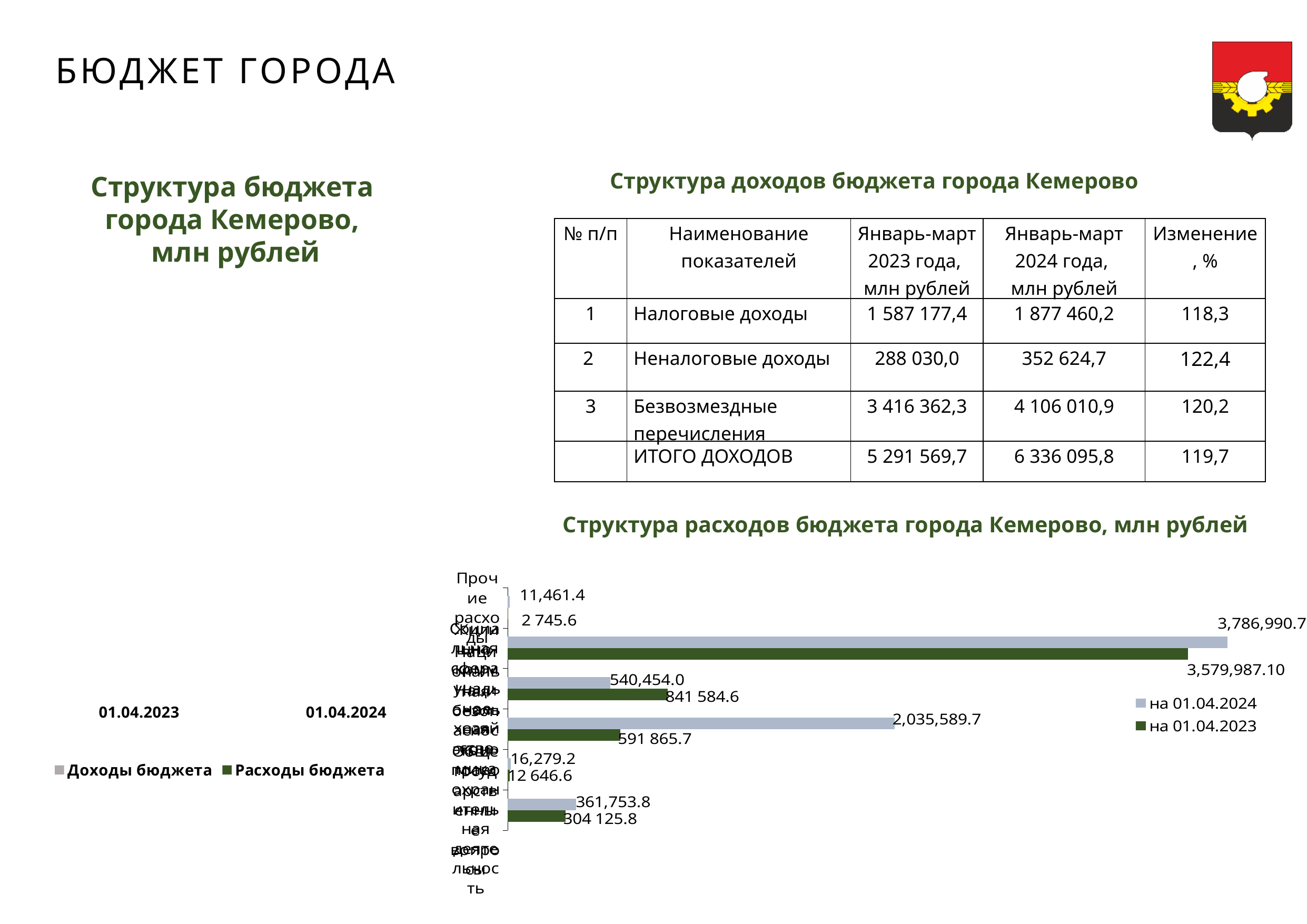
How many categories (groups of bars) are plotted in the 'Структура расходов бюджета города Кемерово, млн рублей' chart? 6 In the 'Структура расходов бюджета города Кемерово, млн рублей' chart, what is the smallest value in the 'на 01.04.2023' series? 2 745.6 In the 'Структура расходов бюджета города Кемерово, млн рублей' chart, what is the smallest value in the 'на 01.04.2024' series? 11,461.4 What kind of chart is the 'Структура расходов бюджета города Кемерово, млн рублей' chart? bar chart In the 'Структура расходов бюджета города Кемерово, млн рублей' chart, what is the largest value in the 'на 01.04.2024' series? 3,786,990.7 What are the two legend entries of the 'Структура бюджета города Кемерово, млн рублей' chart on the left of the slide? Доходы бюджета and Расходы бюджета How many series does the legend of the 'Структура расходов бюджета города Кемерово, млн рублей' chart list? 2 In the 'Структура расходов бюджета города Кемерово, млн рублей' chart, is the largest 'на 01.04.2023' value greater or less than 3,000,000? greater In the 'Структура расходов бюджета города Кемерово, млн рублей' chart, for the category with the longest bars, which series has the larger value? на 01.04.2024 In the 'Структура расходов бюджета города Кемерово, млн рублей' chart, what is the difference between the largest 'на 01.04.2024' value and the largest 'на 01.04.2023' value? 207,003.6 In the 'Структура расходов бюджета города Кемерово, млн рублей' chart, what are the two legend entries? на 01.04.2024 and на 01.04.2023 In the 'Структура расходов бюджета города Кемерово, млн рублей' chart, what is the largest value in the 'на 01.04.2023' series? 3,579,987.10